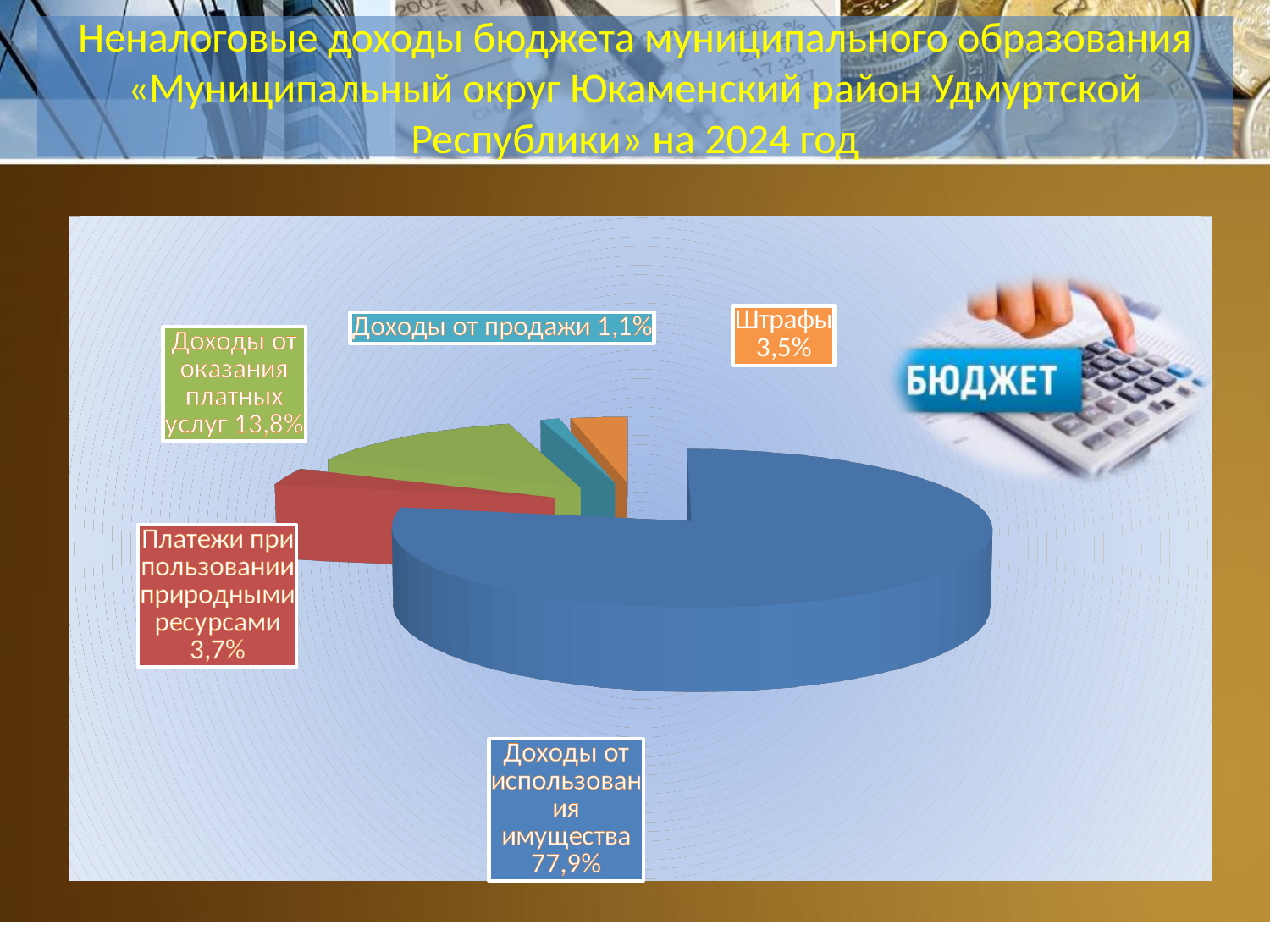
Which category has the largest share of the pie? Доходы от использования имущества What is the value for Платежи при пользовании природными ресурсами? 3,7% What share is shown for Доходы от продажи? 1,1% How many slices does the pie chart have? 5 Which category has the smallest share of the pie? Доходы от продажи What is the difference in percentage points between Доходы от использования имущества and Доходы от оказания платных услуг? 64,1 What percentage is shown for Штрафы? 3,5% What share of non-tax revenue comes from Доходы от использования имущества? 77,9% What type of chart is shown on the slide? Pie chart What year does the chart title refer to? 2024 Which is larger: Доходы от оказания платных услуг or Штрафы? Доходы от оказания платных услуг What is the value shown for Доходы от оказания платных услуг? 13,8%